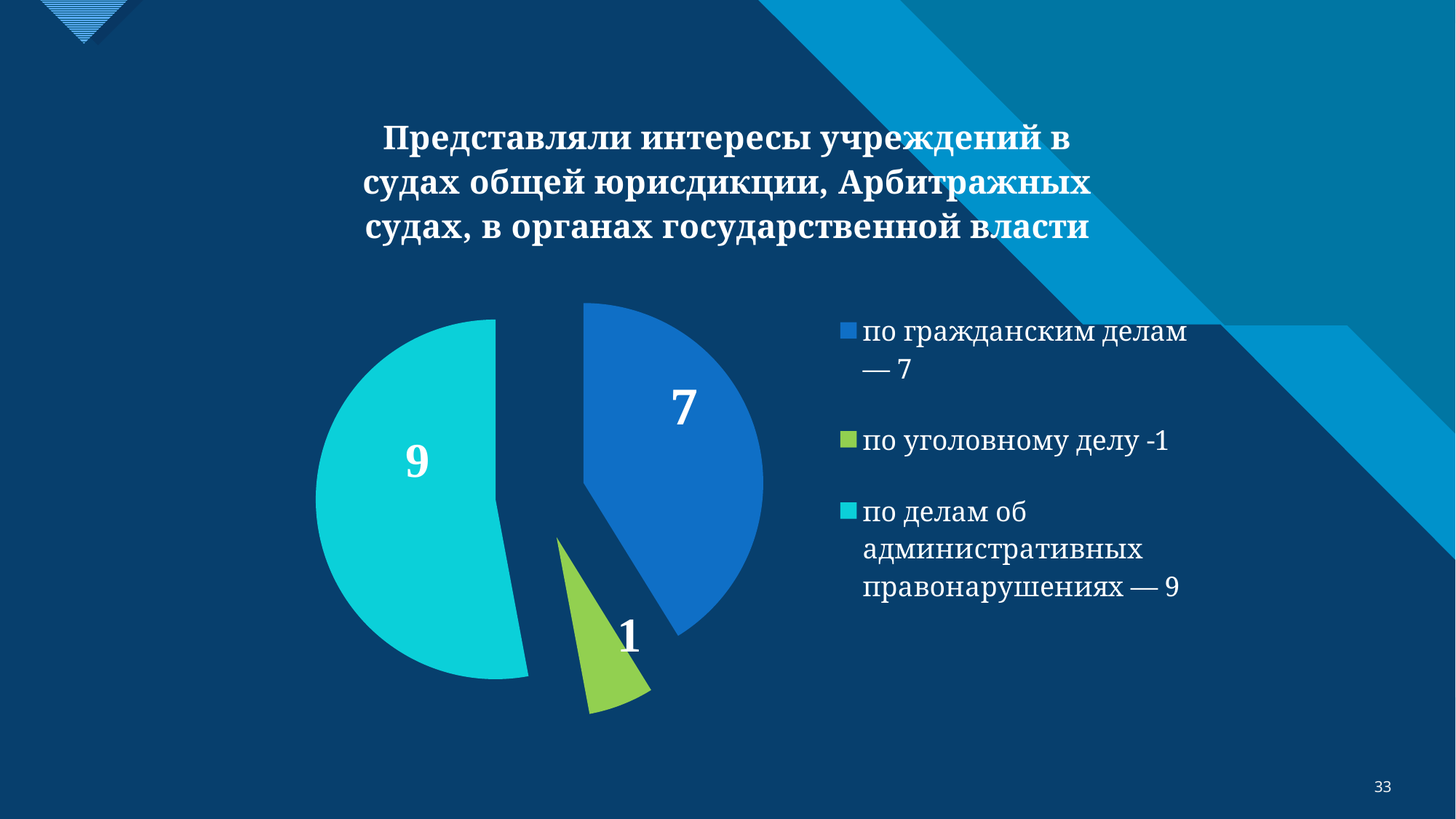
Which category has the smallest slice of the pie? по уголовному делу What is the difference between the values for «по делам об административных правонарушениях» and «по гражданским делам»? 2 What is the total of all three slices in the pie chart? 17 What is the value for «по делам об административных правонарушениях»? 9 What is the value for «по гражданским делам»? 7 Which category has the largest slice of the pie? по делам об административных правонарушениях What is the value for «по уголовному делу»? 1 How many entries does the legend list? 3 Which is larger: the value for «по гражданским делам» or for «по уголовному делу»? по гражданским делам What type of chart is shown on the slide? pie chart What colour is the slice for «по уголовному делу»? green How many slices does the pie chart have? 3